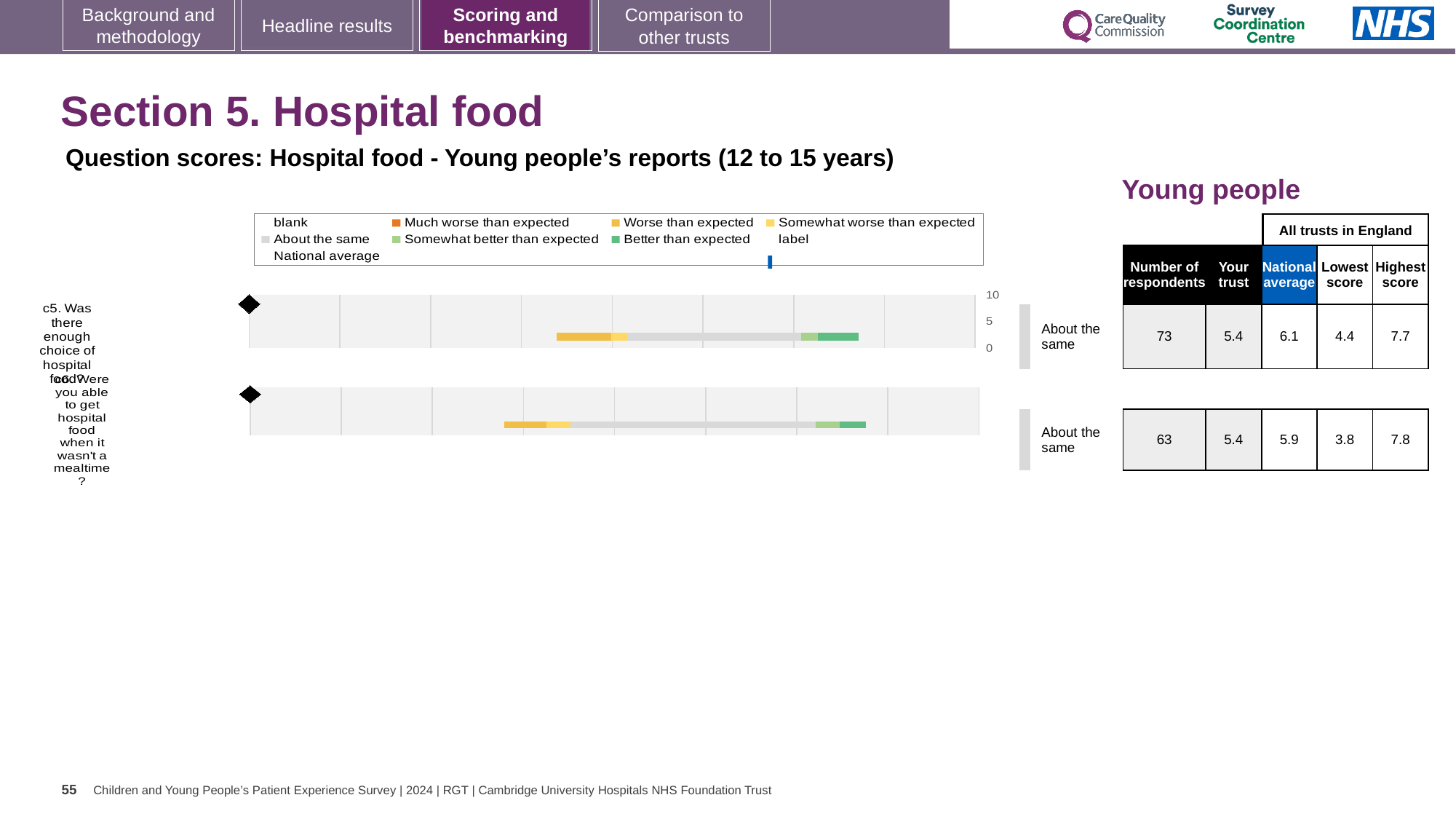
What is the 'Your trust' score for c5 'Was there enough choice of hospital food?'? 5.4 Which question has the higher national average score? c5. Was there enough choice of hospital food? Is the 'Your trust' score for c5 'Was there enough choice of hospital food?' greater or less than 5? greater What is the highest score among all trusts in England for c6 'Were you able to get hospital food when it wasn't a mealtime?'? 7.8 How many respondents answered c6 'Were you able to get hospital food when it wasn't a mealtime?'? 63 What is the national average score for c5 'Was there enough choice of hospital food?'? 6.1 How many questions are plotted in the hospital food chart? 2 What is the difference between the highest and lowest scores for c6 'Were you able to get hospital food when it wasn't a mealtime?'? 4.0 What benchmark category is shown for c5 'Was there enough choice of hospital food?'? About the same What kind of chart is used to show the question scores for hospital food? bar chart By how much does the national average exceed the 'Your trust' score for c5 'Was there enough choice of hospital food?'? 0.7 Which question has the higher lowest score across all trusts in England, c5 or c6? c5